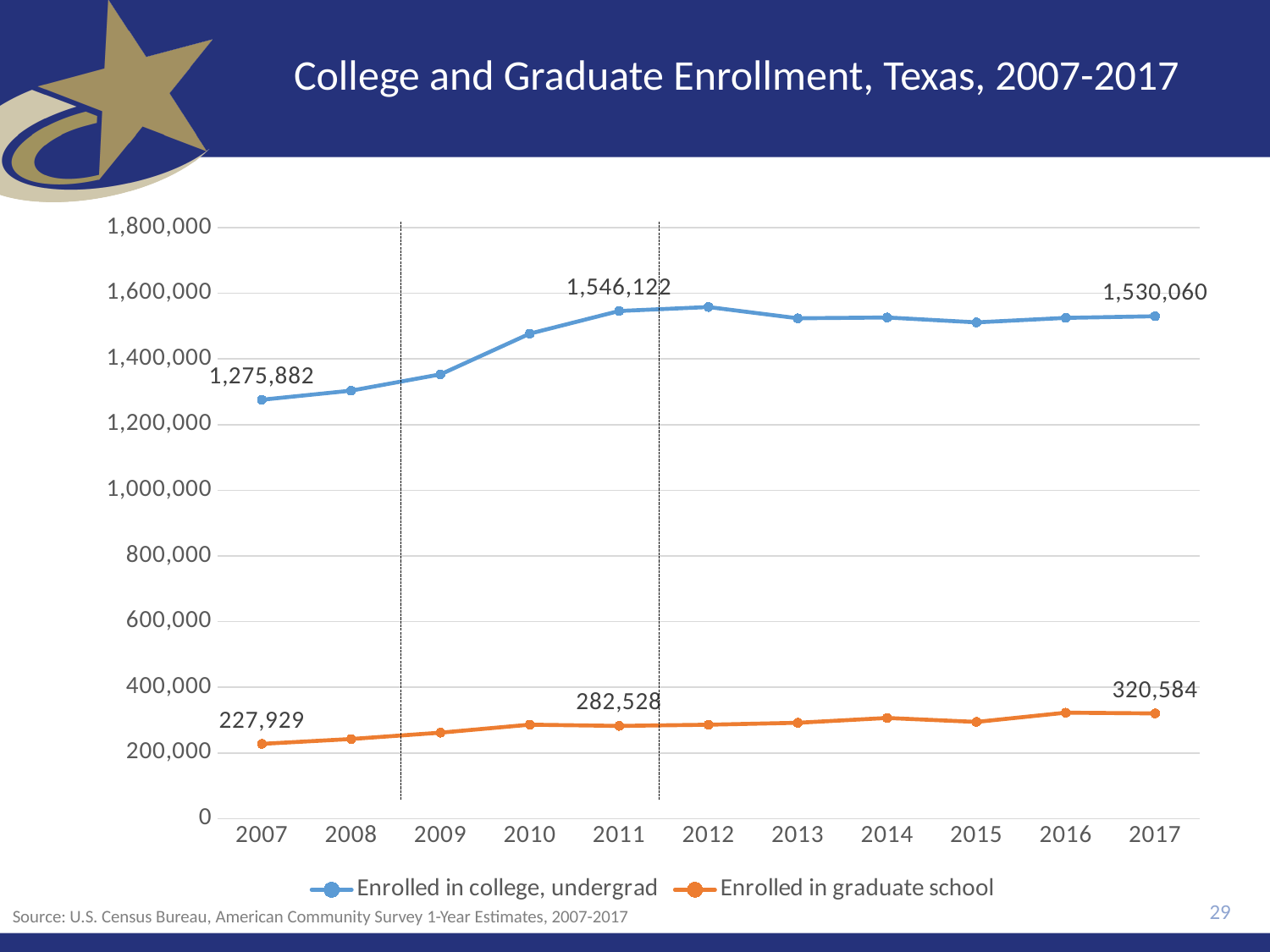
What was the undergraduate enrollment in 2011? 1,546,122 Is the undergraduate enrollment value for 2012 greater or less than 1,400,000? greater How many years are shown on the x axis of the chart? 11 How many series does the legend list? 2 By how much did undergraduate enrollment increase from 2007 to 2011? 270,240 What kind of chart is shown on the slide? Line chart What was the number enrolled in college, undergrad in Texas in 2007? 1,275,882 What is the difference between graduate school enrollment in 2017 and in 2007? 92,655 What was the graduate school enrollment in 2011? 282,528 Which was larger, undergraduate enrollment in 2011 or in 2017? 2011 Is the graduate school enrollment value for 2014 greater or less than 400,000? less What was the number enrolled in graduate school in Texas in 2017? 320,584